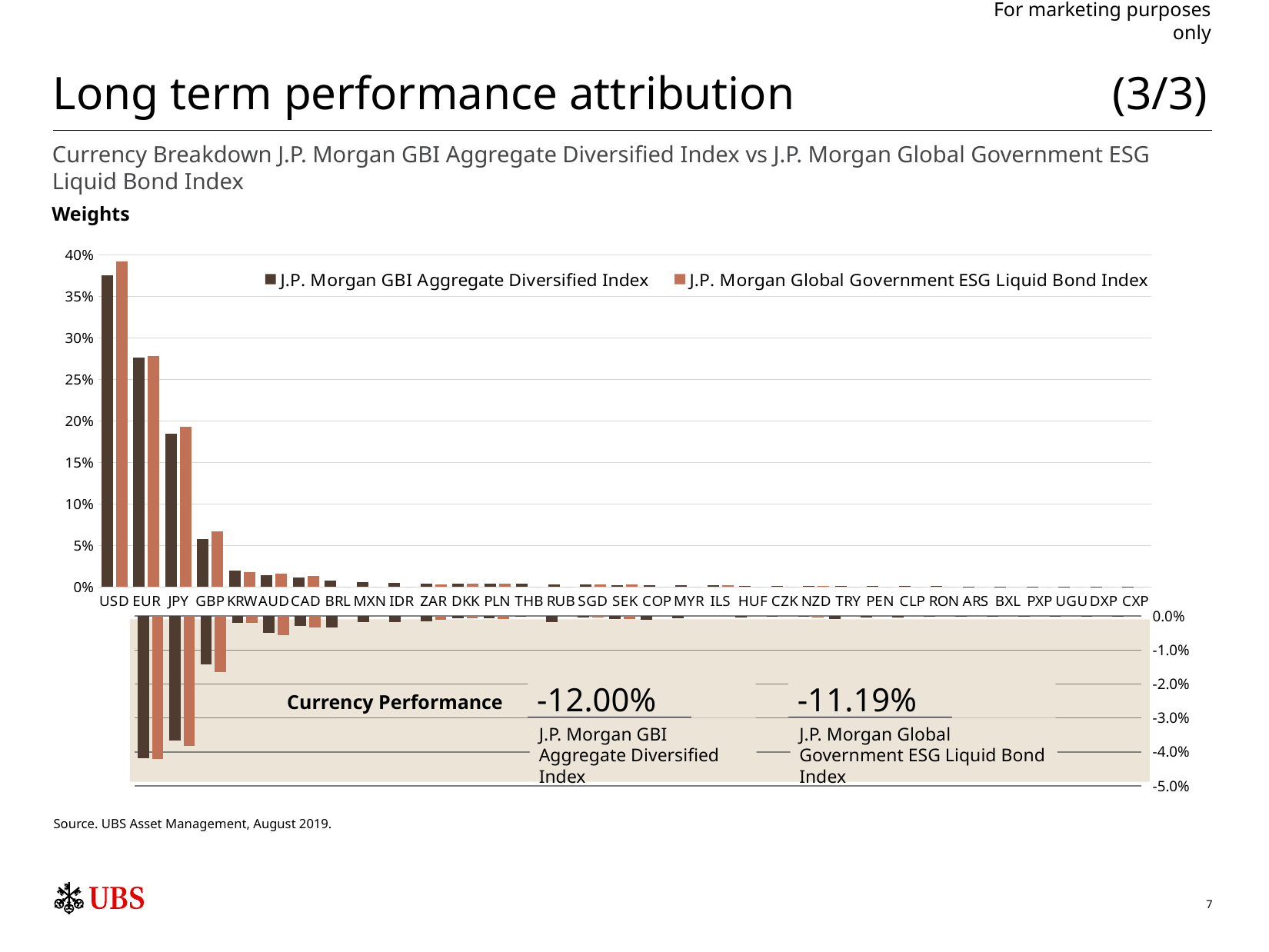
On the Weights chart, do the weights generally rise or fall moving from left to right along the x axis? fall On the Weights chart, how many series does the legend list? 2 On the Weights chart, how many currency categories are shown on the x axis? 33 On the Weights chart, is the KRW weight for the J.P. Morgan Global Government ESG Liquid Bond Index greater or less than 5%? less On the Weights chart, is the USD weight for the J.P. Morgan GBI Aggregate Diversified Index greater or less than 35%? greater On the Weights chart, for USD, which series has the larger weight: the J.P. Morgan GBI Aggregate Diversified Index or the J.P. Morgan Global Government ESG Liquid Bond Index? J.P. Morgan Global Government ESG Liquid Bond Index On the Weights chart, which currency has the highest weight in the J.P. Morgan GBI Aggregate Diversified Index? USD On the Weights chart, what kind of chart is shown? bar chart On the Weights chart, which currency has the highest weight in the J.P. Morgan Global Government ESG Liquid Bond Index? USD On the Weights chart, is the GBP weight for the J.P. Morgan GBI Aggregate Diversified Index greater or less than 5%? greater On the Weights chart, what is the highest value shown on the y axis? 40%